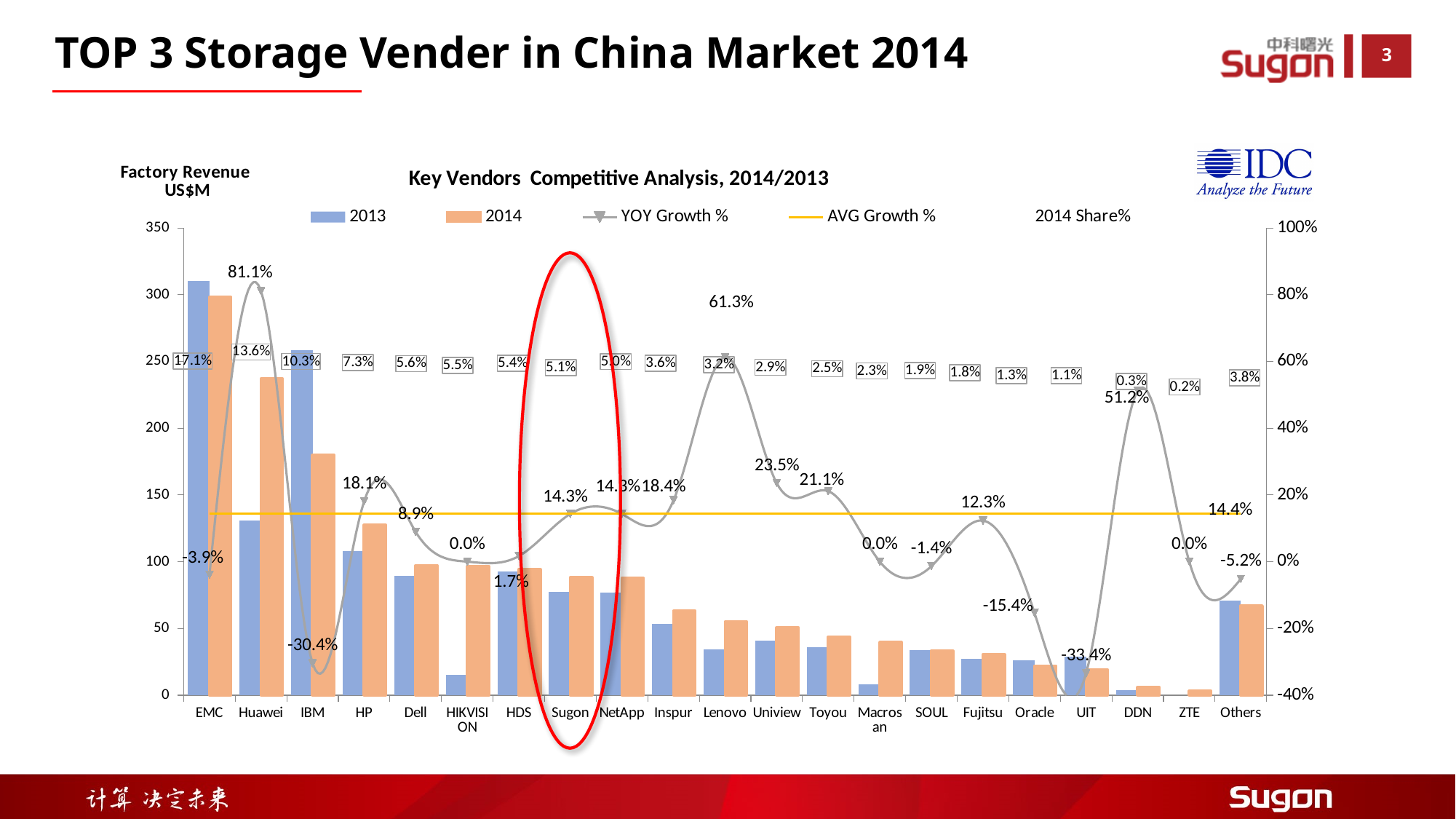
Which vendor has the larger 2014 Share%, EMC or Huawei? EMC How many vendor categories are shown on the x axis? 21 What kind of chart is shown on the slide? bar and line chart How many series does the legend list? 5 Which vendor has the lowest YOY Growth %? UIT What is the AVG Growth % value shown on the chart? 14.4% What is the difference between the YOY Growth % of Huawei and Lenovo? 19.8 percentage points What is the YOY Growth % for Huawei? 81.1% Which vendor has the highest YOY Growth %? Huawei What is the 2014 Share% for Sugon? 5.1% What is the YOY Growth % for IBM? -30.4% Is the 2013 factory revenue bar for EMC greater or less than 300? greater